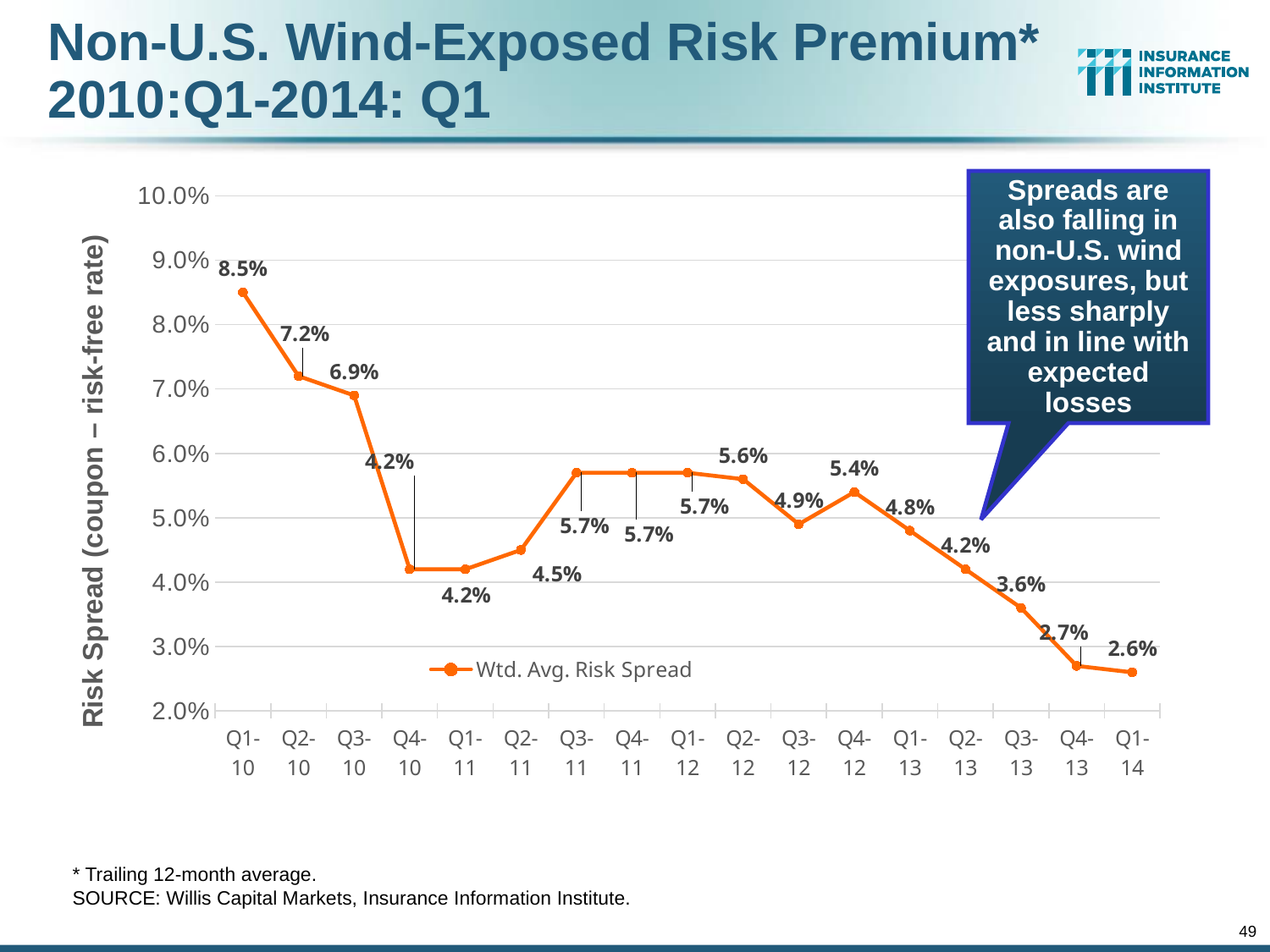
What is the weighted average risk spread for Q1-10? 8.5% What is the weighted average risk spread for Q4-12? 5.4% Which quarter has the lowest weighted average risk spread? Q1-14 How many series does the legend list? 1 How many quarters are plotted on the x axis? 17 Is the risk spread for Q3-13 greater or less than 4.0%? less Which quarter has the highest weighted average risk spread? Q1-10 What is the name of the series shown in the legend? Wtd. Avg. Risk Spread What is the difference between the risk spread in Q1-10 and Q1-14? 5.9% Which is larger, the risk spread in Q2-10 or in Q3-10? Q2-10 What is the weighted average risk spread for Q1-14? 2.6% What type of chart is shown on the slide? Line chart